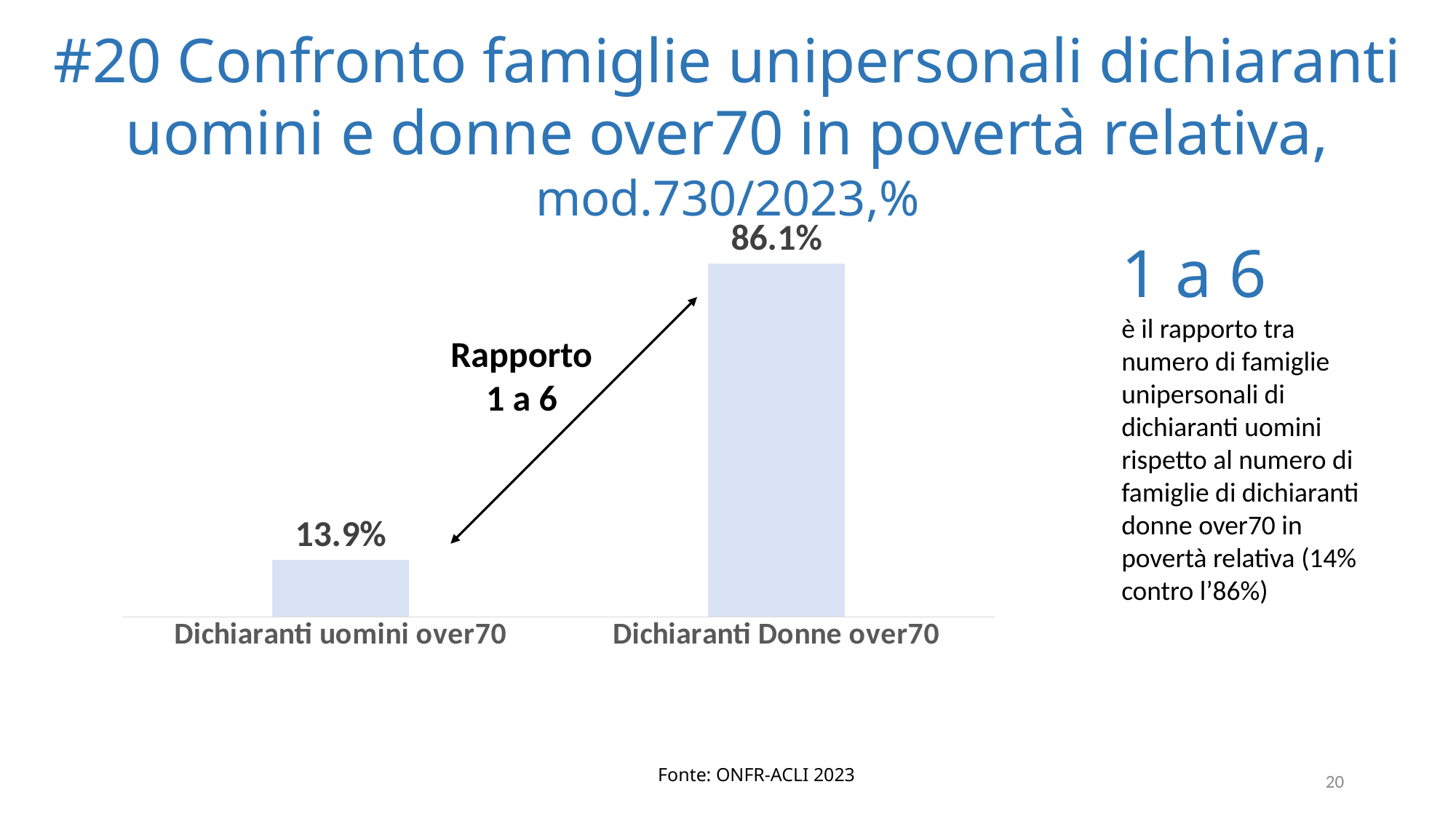
How many categories are shown in the chart? 2 What source is cited at the bottom of the slide? Fonte: ONFR-ACLI 2023 What is the value for Dichiaranti Donne over70? 86.1% What is the value for Dichiaranti uomini over70? 13.9% What ratio is written next to the arrow between the two bars? Rapporto 1 a 6 What is the difference between the value for Dichiaranti Donne over70 and the value for Dichiaranti uomini over70? 72.2% Which is larger, the value for Dichiaranti uomini over70 or the value for Dichiaranti Donne over70? Dichiaranti Donne over70 Which category has the highest value? Dichiaranti Donne over70 What kind of chart is shown on the slide? Bar chart What is the total of the two values shown in the chart? 100% Which category has the lowest value? Dichiaranti uomini over70